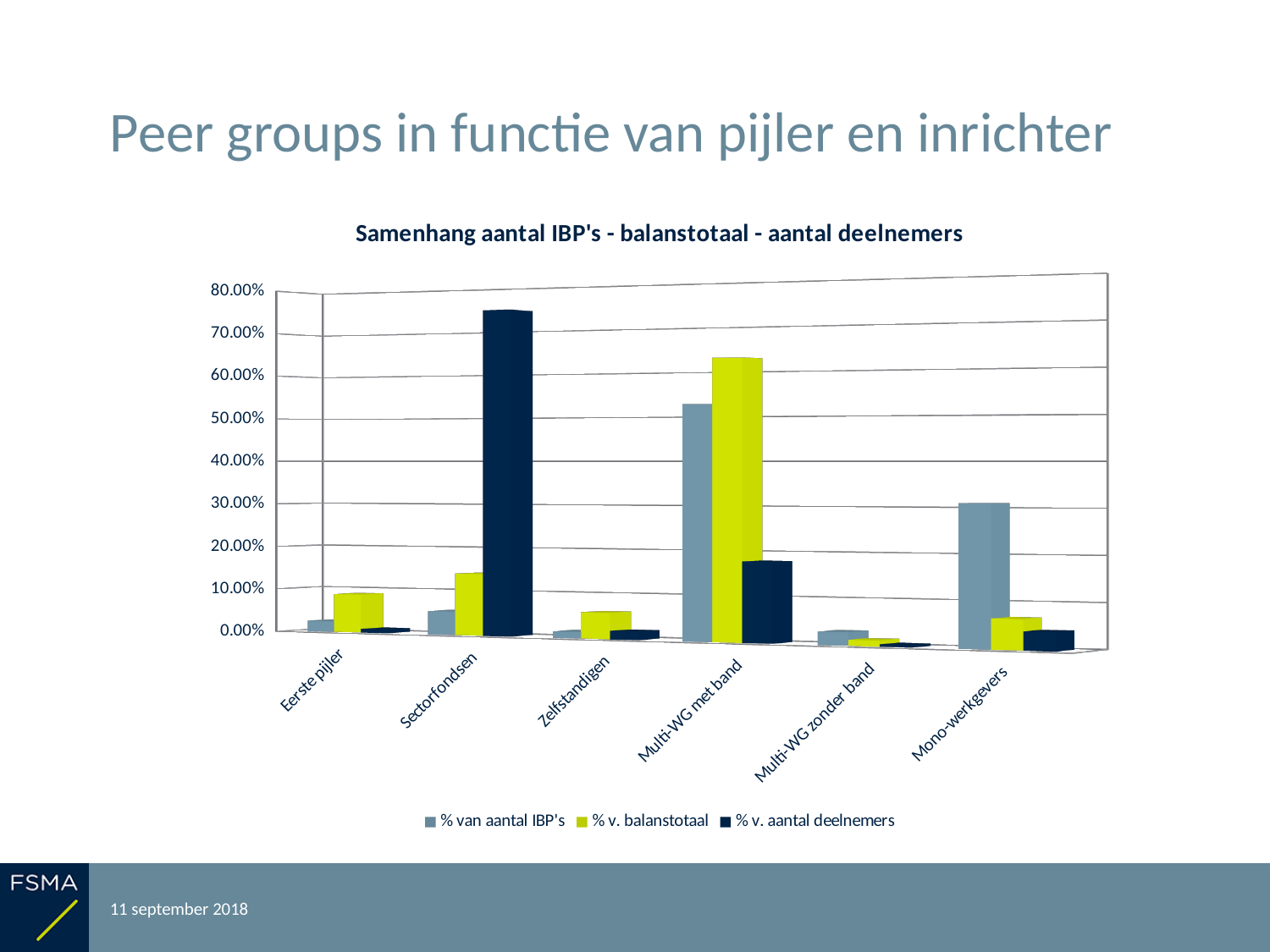
How many categories are shown along the x axis of the chart? 6 Is the value of '% van aantal IBP's' for Mono-werkgevers greater or less than 20.00%? greater Which category has the highest value for the series '% van aantal IBP's'? Multi-WG met band Which category has the highest value for the series '% v. balanstotaal'? Multi-WG met band Is the value of '% v. balanstotaal' for Multi-WG met band greater or less than 50.00%? greater What is the title of the chart? Samenhang aantal IBP's - balanstotaal - aantal deelnemers How many series does the chart's legend list? 3 For Multi-WG met band, which is larger: '% van aantal IBP's' or '% v. balanstotaal'? % v. balanstotaal Which category has the highest value for the series '% v. aantal deelnemers'? Sectorfondsen For Sectorfondsen, which is larger: '% v. balanstotaal' or '% v. aantal deelnemers'? % v. aantal deelnemers What kind of chart is shown on the slide? Bar chart Is the value of '% v. aantal deelnemers' for Sectorfondsen greater or less than 70.00%? greater